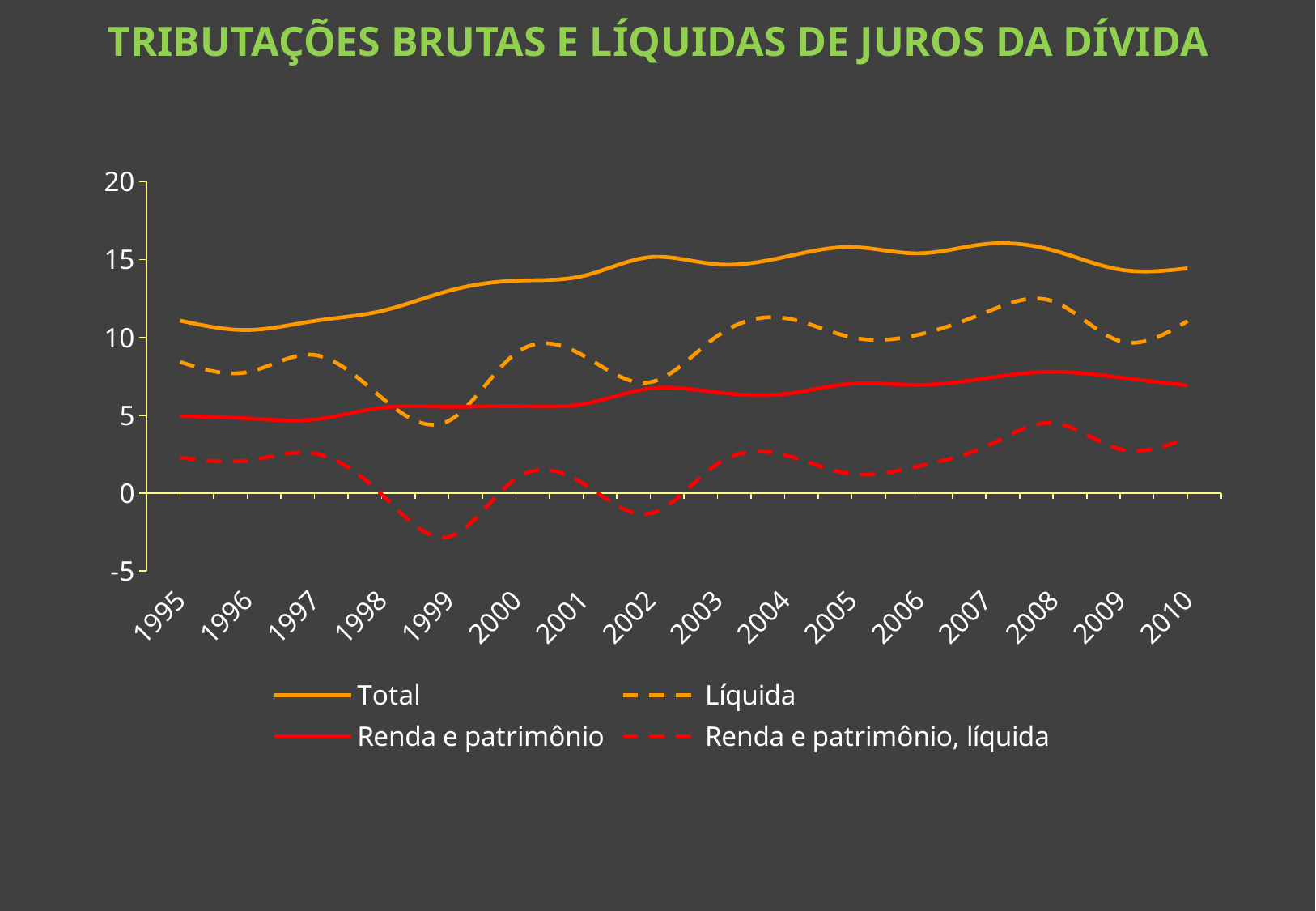
In which year does the 'Renda e patrimônio, líquida' series reach its lowest value? 1999 How many series does the legend list? 4 In 2004, which is higher: the Total series or the Líquida series? Total Is the value of the Líquida series in 1999 greater or less than 5? less Is the value of the Total series in 1995 greater or less than 10? greater What is the title of the chart? TRIBUTAÇÕES BRUTAS E LÍQUIDAS DE JUROS DA DÍVIDA Does the Total series generally rise or fall from 1995 to 2008? rise Is the value of the Total series in 2008 greater or less than 15? greater How many years are shown along the x axis? 16 What kind of chart is shown on the slide? line chart In which year does the Líquida series reach its lowest value? 1999